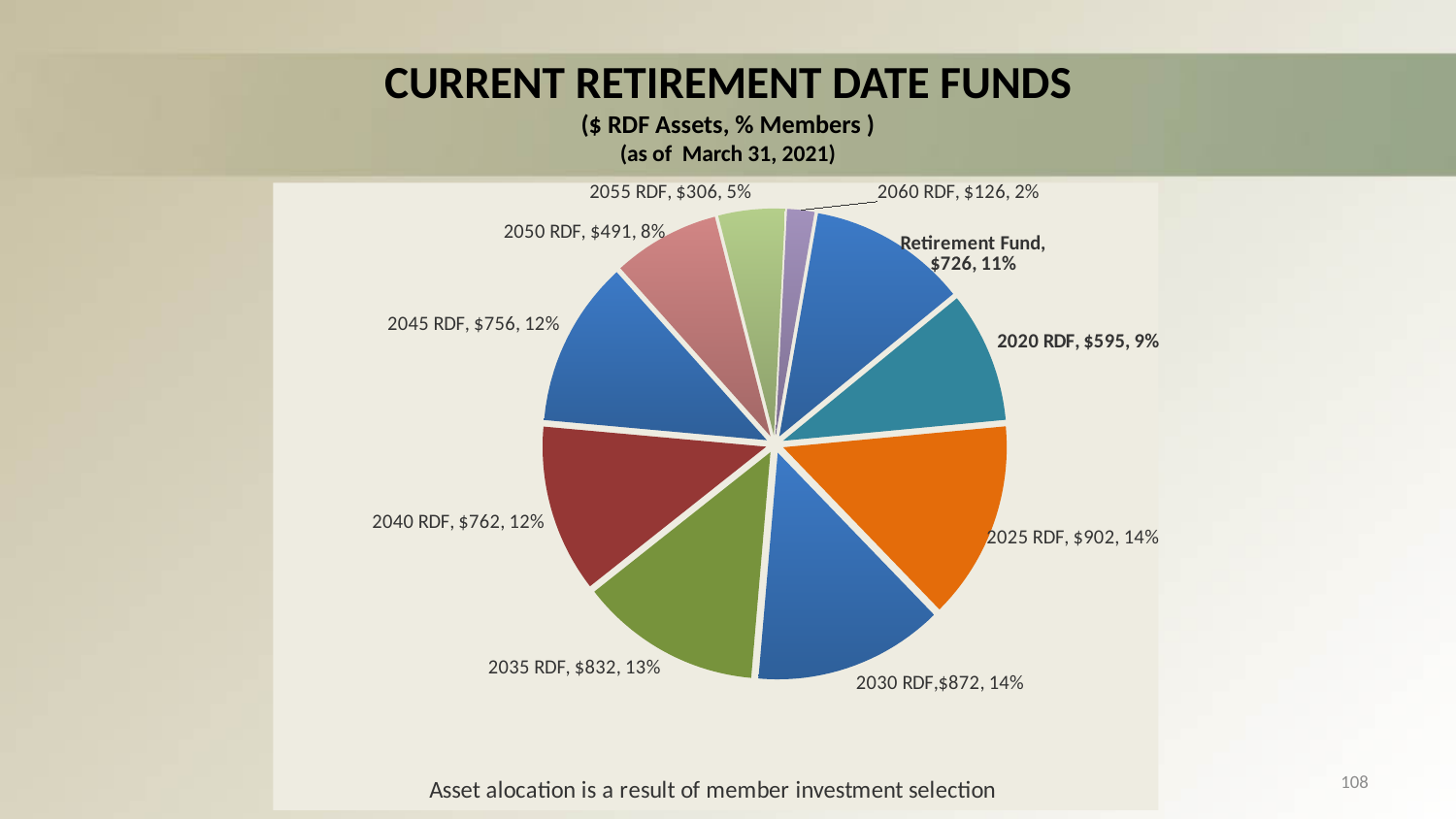
What kind of chart is shown on the slide? pie chart What are the RDF assets for the 2025 RDF? $902 Which fund has the largest RDF assets? 2025 RDF What is the title of the chart? CURRENT RETIREMENT DATE FUNDS What is the combined RDF assets of the 2055 RDF and the 2060 RDF? $432 Which fund has the smallest RDF assets? 2060 RDF What is the difference in RDF assets between the 2030 RDF and the 2020 RDF? $277 What percentage of members is shown for the 2035 RDF? 13% What share of members does the 2060 RDF slice represent? 2% Which has larger RDF assets, the 2040 RDF or the 2050 RDF? 2040 RDF How many slices does the pie chart have? 10 What are the RDF assets for the Retirement Fund? $726